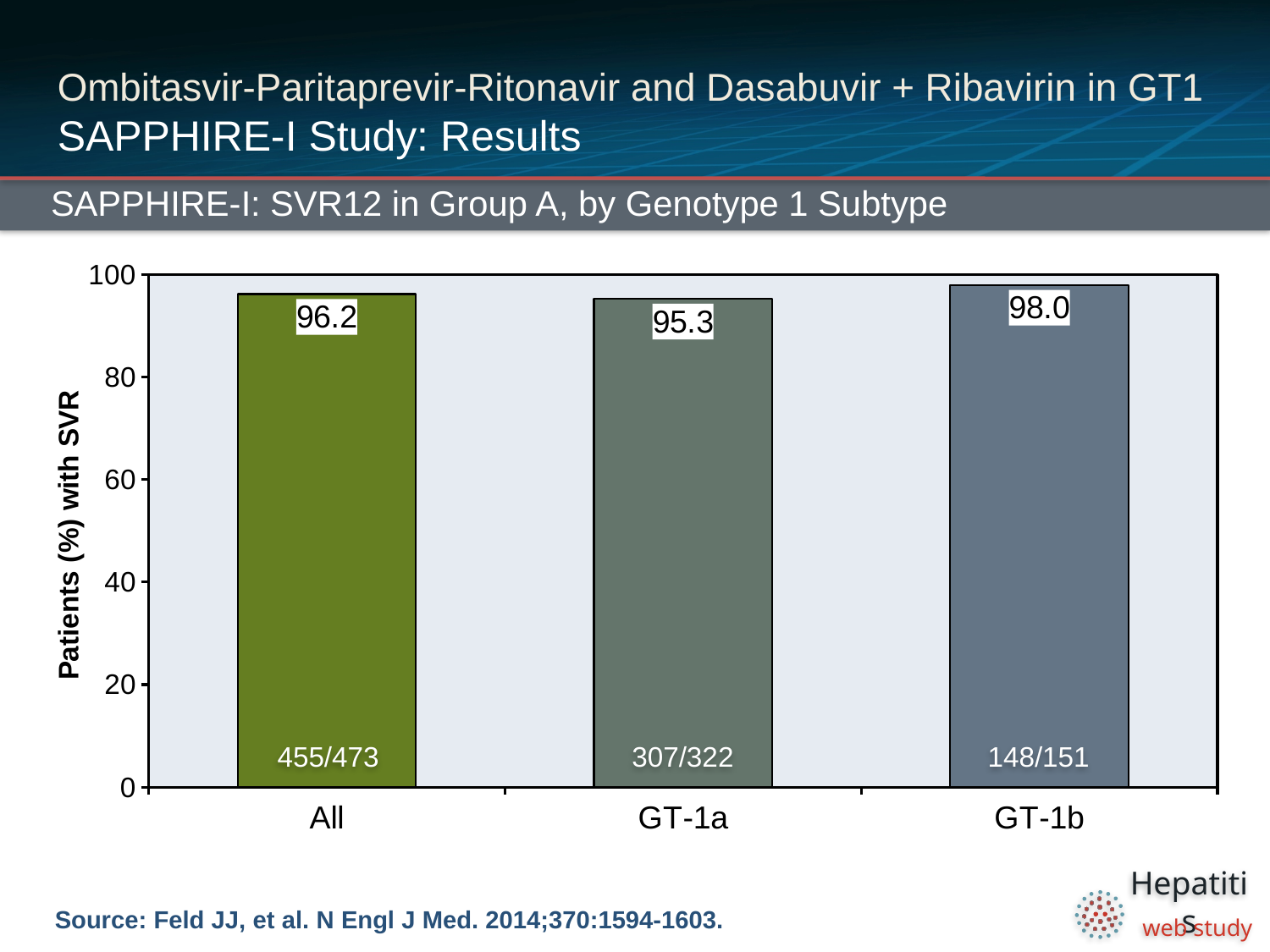
What fraction of patients is printed inside the GT-1b bar? 148/151 What is the SVR12 rate for GT-1b? 98.0 Which has a higher SVR12 rate, All or GT-1a? All How many categories are shown on the x axis? 3 Which category has the highest SVR12 rate? GT-1b What is the label of the y axis? Patients (%) with SVR What kind of chart is shown on the slide? Bar chart What is the SVR12 rate for the All group? 96.2 Which category has the lowest SVR12 rate? GT-1a What fraction of patients is printed inside the GT-1a bar? 307/322 What is the SVR12 rate for GT-1a? 95.3 What is the difference in SVR12 rate between GT-1b and GT-1a? 2.7